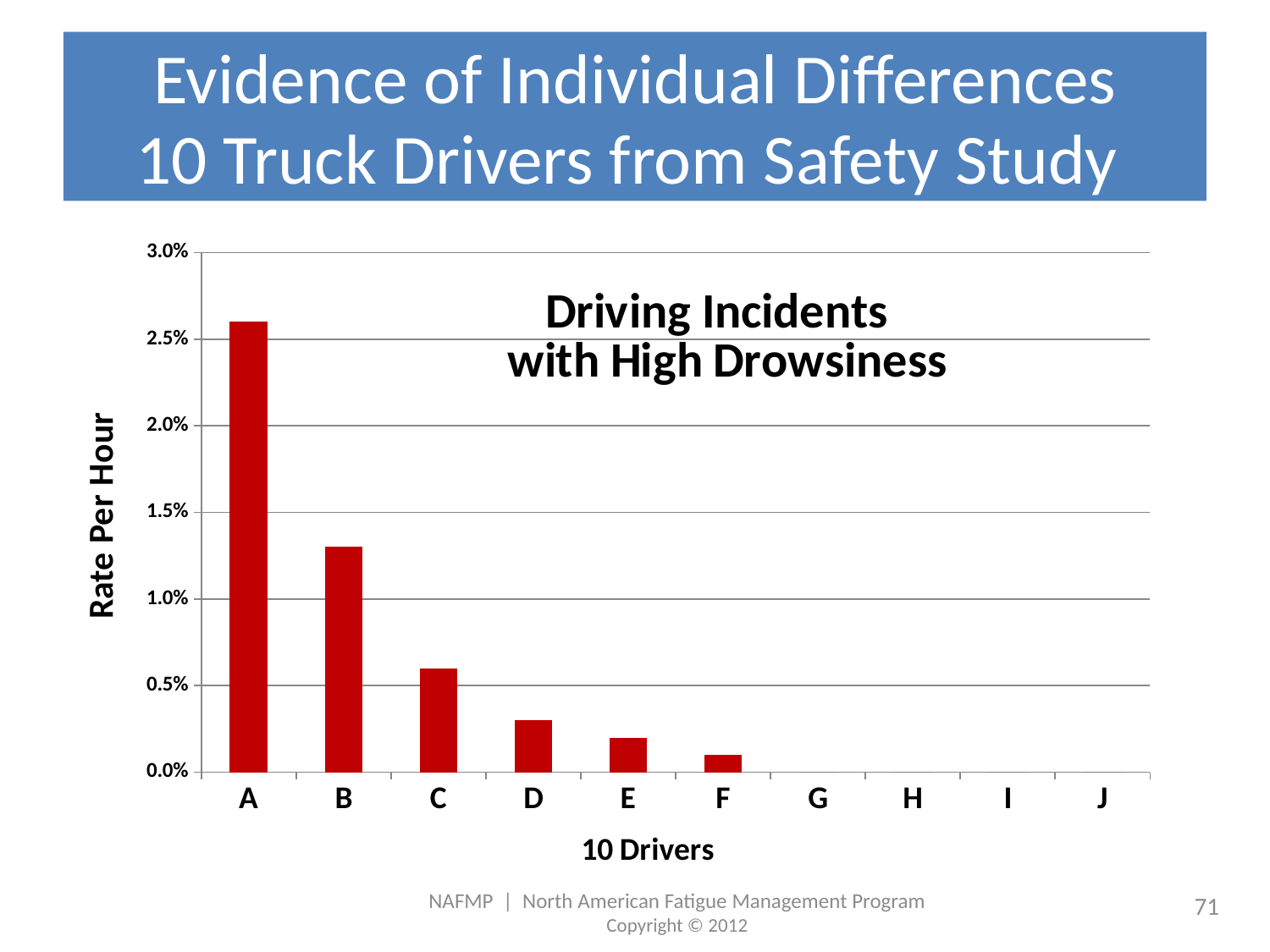
Is the value for driver B greater or less than 1.0%? greater Do the values rise or fall moving from driver A to driver J along the x axis? fall Is the value for driver C greater or less than 1.0%? less What kind of chart is shown on the slide? bar chart Is the value for driver F greater or less than 0.5%? less What is the title of the chart? Driving Incidents with High Drowsiness Which driver has the highest rate of driving incidents with high drowsiness? A How many drivers are shown on the x axis of the chart? 10 Which driver has a higher rate per hour, B or C? B What is the label on the vertical axis of the chart? Rate Per Hour